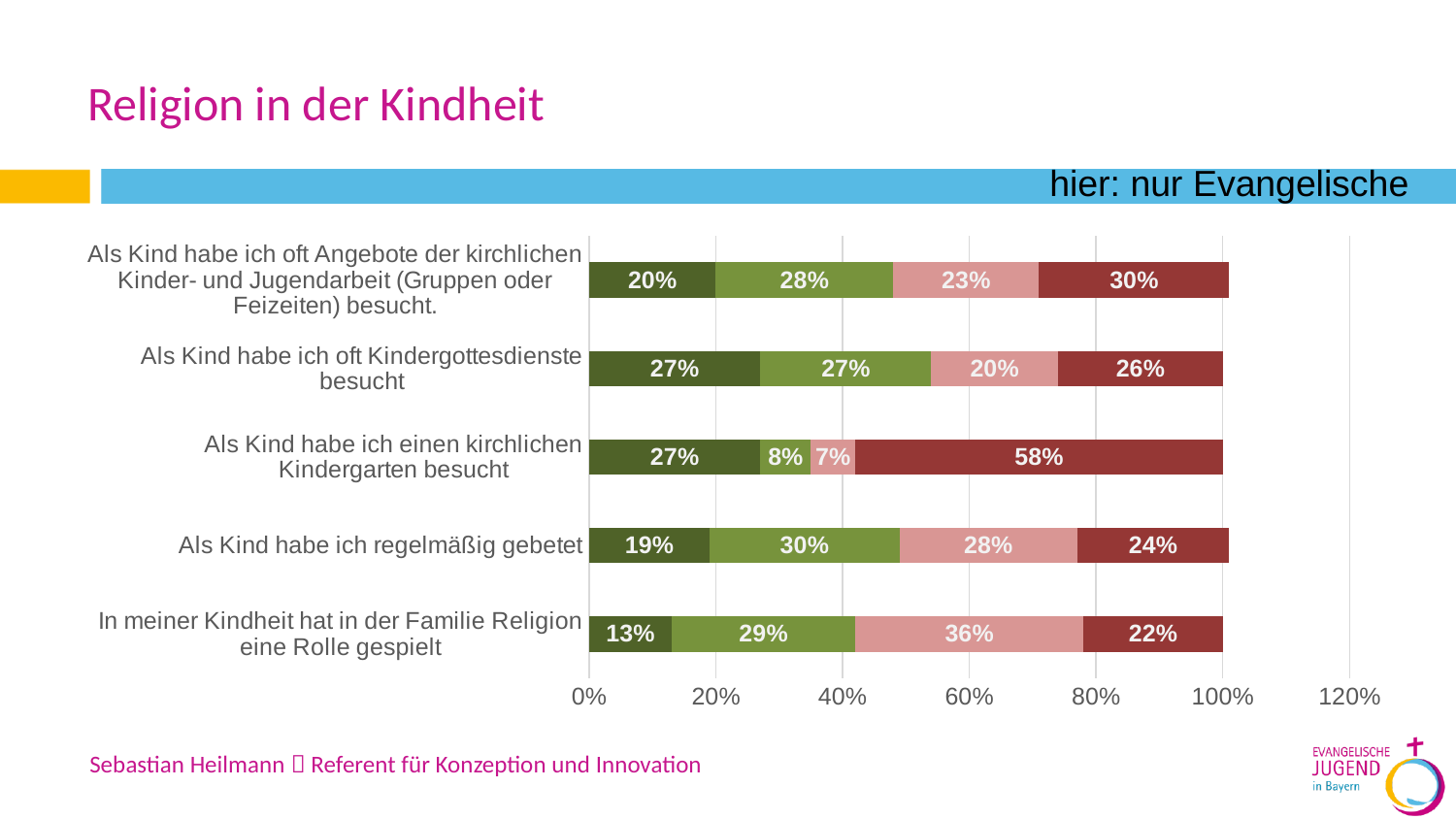
What is the value of the dark green (leftmost) segment for 'In meiner Kindheit hat in der Familie Religion eine Rolle gespielt'? 13% Which statement has the smallest dark green (leftmost) segment? In meiner Kindheit hat in der Familie Religion eine Rolle gespielt How many statements (categories) are plotted in the chart? 5 What kind of chart is shown on the slide? Stacked bar chart What is the value of the pink (third) segment for 'Als Kind habe ich regelmäßig gebetet'? 28% What is the value of the dark red (rightmost) segment for 'Als Kind habe ich einen kirchlichen Kindergarten besucht'? 58% Which is larger: the pink segment for 'In meiner Kindheit hat in der Familie Religion eine Rolle gespielt' or the pink segment for 'Als Kind habe ich oft Kindergottesdienste besucht'? In meiner Kindheit hat in der Familie Religion eine Rolle gespielt Which statement has the largest dark red (rightmost) segment? Als Kind habe ich einen kirchlichen Kindergarten besucht What is the total of the four segments for 'Als Kind habe ich oft Kindergottesdienste besucht'? 100% What subtitle appears in the blue band above the chart? hier: nur Evangelische What is the difference between the dark red segment (58%) and the pink segment (7%) for 'Als Kind habe ich einen kirchlichen Kindergarten besucht'? 51 percentage points What is the value of the light green (second) segment for 'Als Kind habe ich oft Kindergottesdienste besucht'? 27%